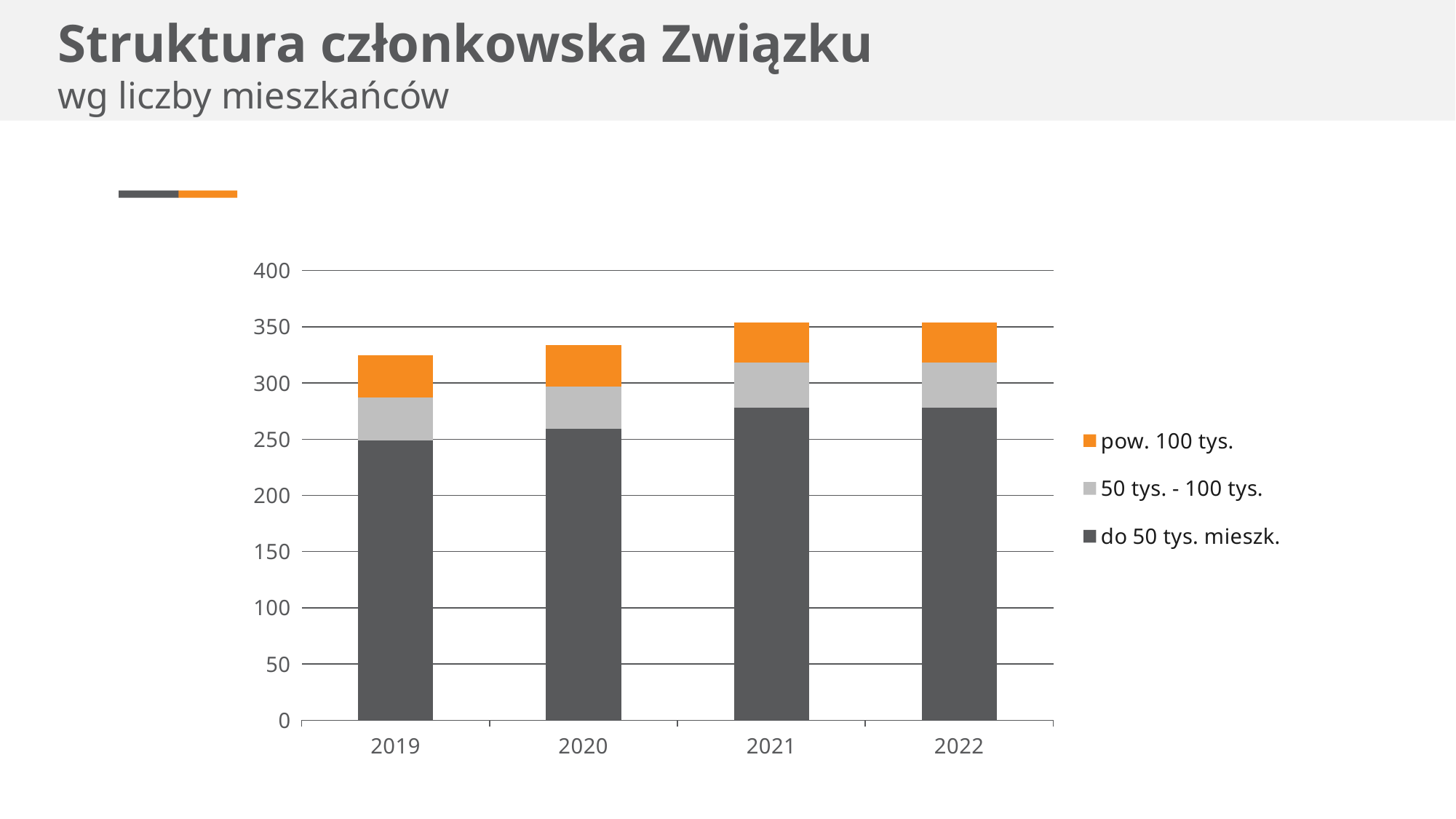
Which bar is taller in total, 2019 or 2021? 2021 How many series does the chart legend list? 3 Is the 'do 50 tys. mieszk.' segment for 2019 greater or less than 300? less What kind of chart is shown on the slide? stacked bar chart How many years are shown on the x axis of the chart? 4 Which year has the lowest total bar height? 2019 Is the total height of the 2020 bar greater or less than 350? less What is the main title of the slide? Struktura członkowska Związku Is the 'do 50 tys. mieszk.' segment for 2021 greater or less than 250? greater Which colour represents the 'pow. 100 tys.' series in the legend? orange Do the total bar heights rise or fall from 2019 to 2022? rise